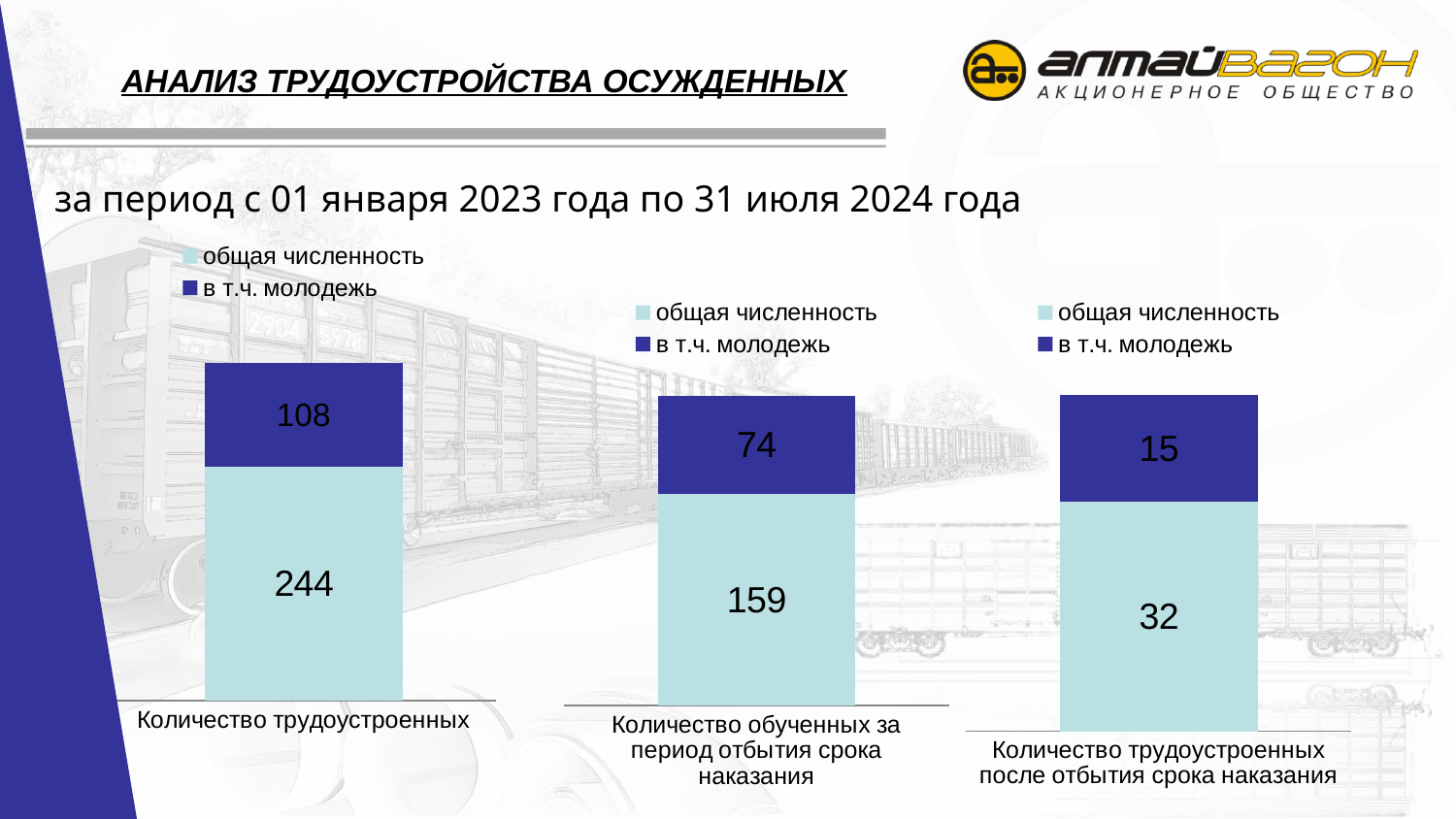
In the chart labelled "Количество обученных за период отбытия срока наказания", what is the value for "общая численность"? 159 In the chart labelled "Количество трудоустроенных", what is the difference between "общая численность" and "в т.ч. молодежь"? 136 What kind of chart is the chart labelled "Количество трудоустроенных после отбытия срока наказания"? stacked bar chart In the chart labelled "Количество трудоустроенных после отбытия срока наказания", what is the sum of the two stacked segments? 47 In the chart labelled "Количество трудоустроенных", what is the value for "общая численность"? 244 In the chart labelled "Количество обученных за период отбытия срока наказания", what is the difference between "общая численность" and "в т.ч. молодежь"? 85 How many series does the legend of the chart labelled "Количество трудоустроенных" list? 2 In the chart labelled "Количество трудоустроенных после отбытия срока наказания", what is the value for "общая численность"? 32 Which is larger: "общая численность" in the chart labelled "Количество трудоустроенных" or "общая численность" in the chart labelled "Количество обученных за период отбытия срока наказания"? Количество трудоустроенных In the chart labelled "Количество трудоустроенных после отбытия срока наказания", what is the value for "в т.ч. молодежь"? 15 In the chart labelled "Количество трудоустроенных", what is the value for "в т.ч. молодежь"? 108 In the chart labelled "Количество обученных за период отбытия срока наказания", what is the value for "в т.ч. молодежь"? 74